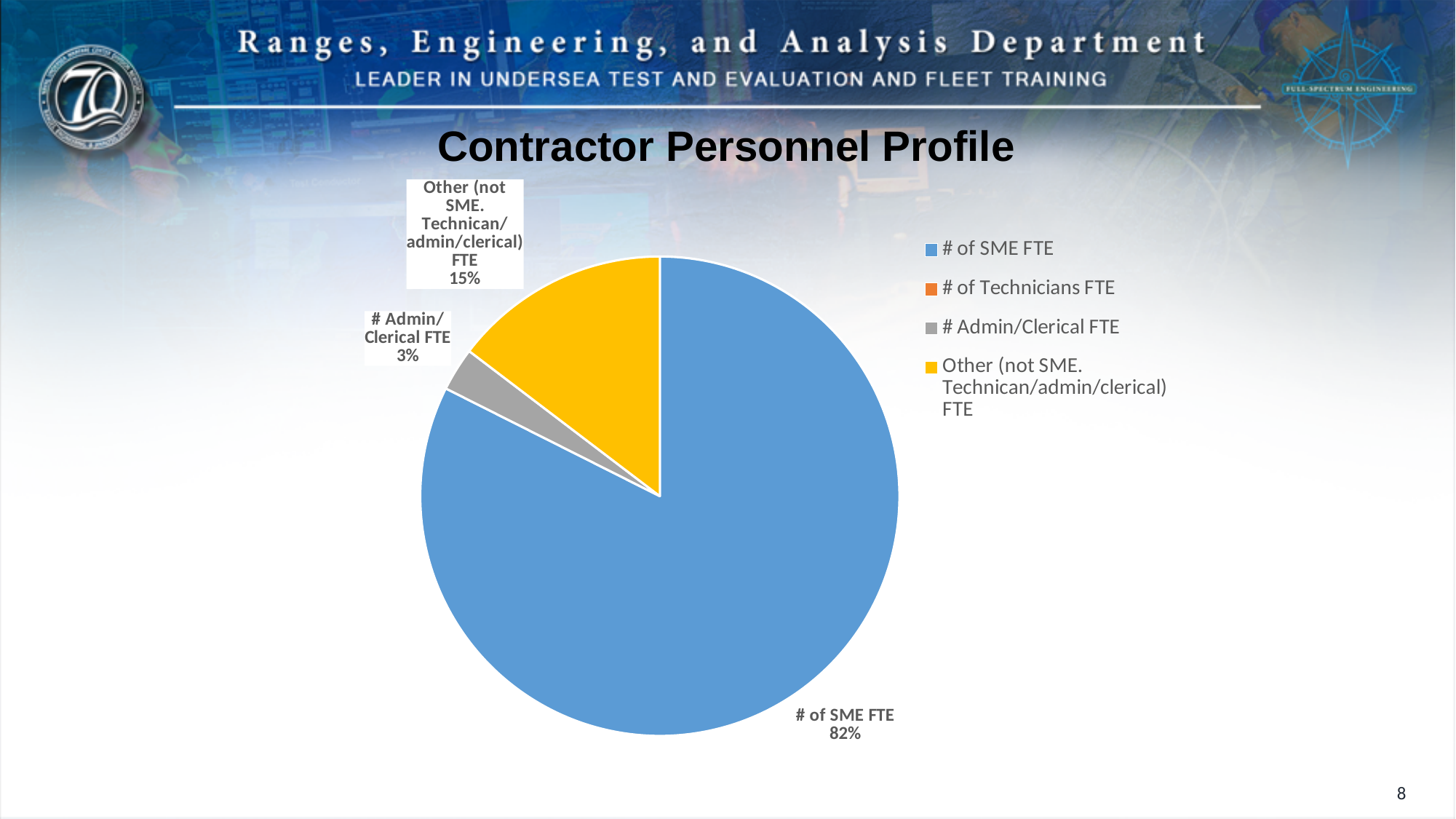
What is the title of the chart? Contractor Personnel Profile What share of the pie is # Admin/Clerical FTE? 3% What is the difference in percentage points between # of SME FTE and Other (not SME. Technican/admin/clerical) FTE? 67 What share of the pie is # of SME FTE? 82% Which is larger, the share for Other (not SME. Technican/admin/clerical) FTE or the share for # Admin/Clerical FTE? Other (not SME. Technican/admin/clerical) FTE What share of the pie is Other (not SME. Technican/admin/clerical) FTE? 15% What colour is the # of SME FTE slice? Blue What kind of chart is shown on the slide? Pie chart Which category has the largest slice of the pie? # of SME FTE How many entries does the legend list? 4 What is the difference in percentage points between Other (not SME. Technican/admin/clerical) FTE and # Admin/Clerical FTE? 12 Which labelled slice is the smallest? # Admin/Clerical FTE